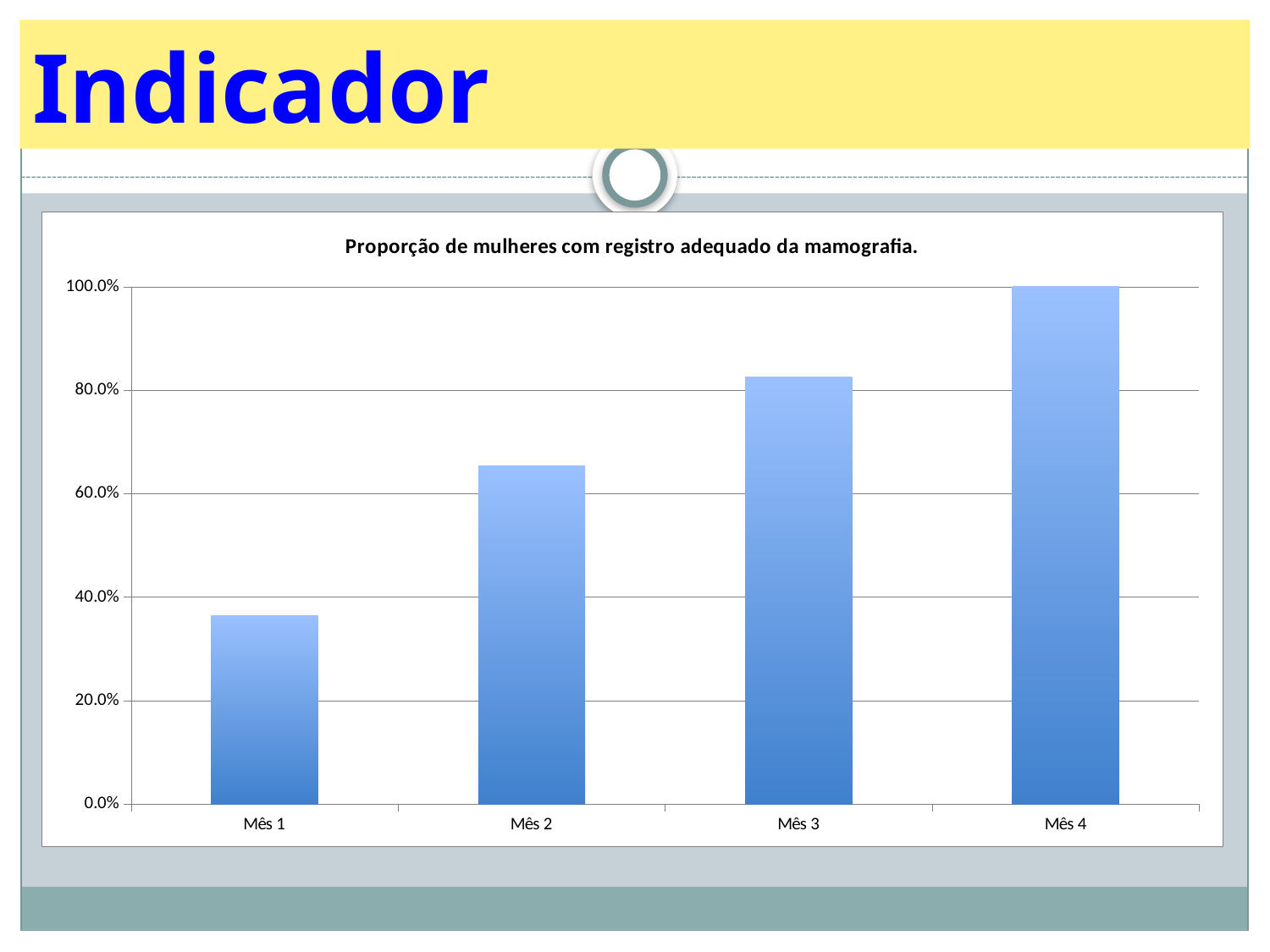
Do the values rise or fall from Mês 1 to Mês 4? rise Is the value for Mês 1 greater or less than 40.0%? less Which is larger, the value for Mês 1 or the value for Mês 2? Mês 2 How many categories (months) are plotted on the chart? 4 Is the value for Mês 3 greater or less than 80.0%? greater Which is larger, the value for Mês 2 or the value for Mês 3? Mês 3 Which month has the lowest proportion of women with adequate mammography records? Mês 1 What is the value for Mês 4? 100.0% What kind of chart is shown on the slide? bar chart Is the value for Mês 2 greater or less than 60.0%? greater What is the title of the chart? Proporção de mulheres com registro adequado da mamografia. Which month has the highest proportion of women with adequate mammography records? Mês 4